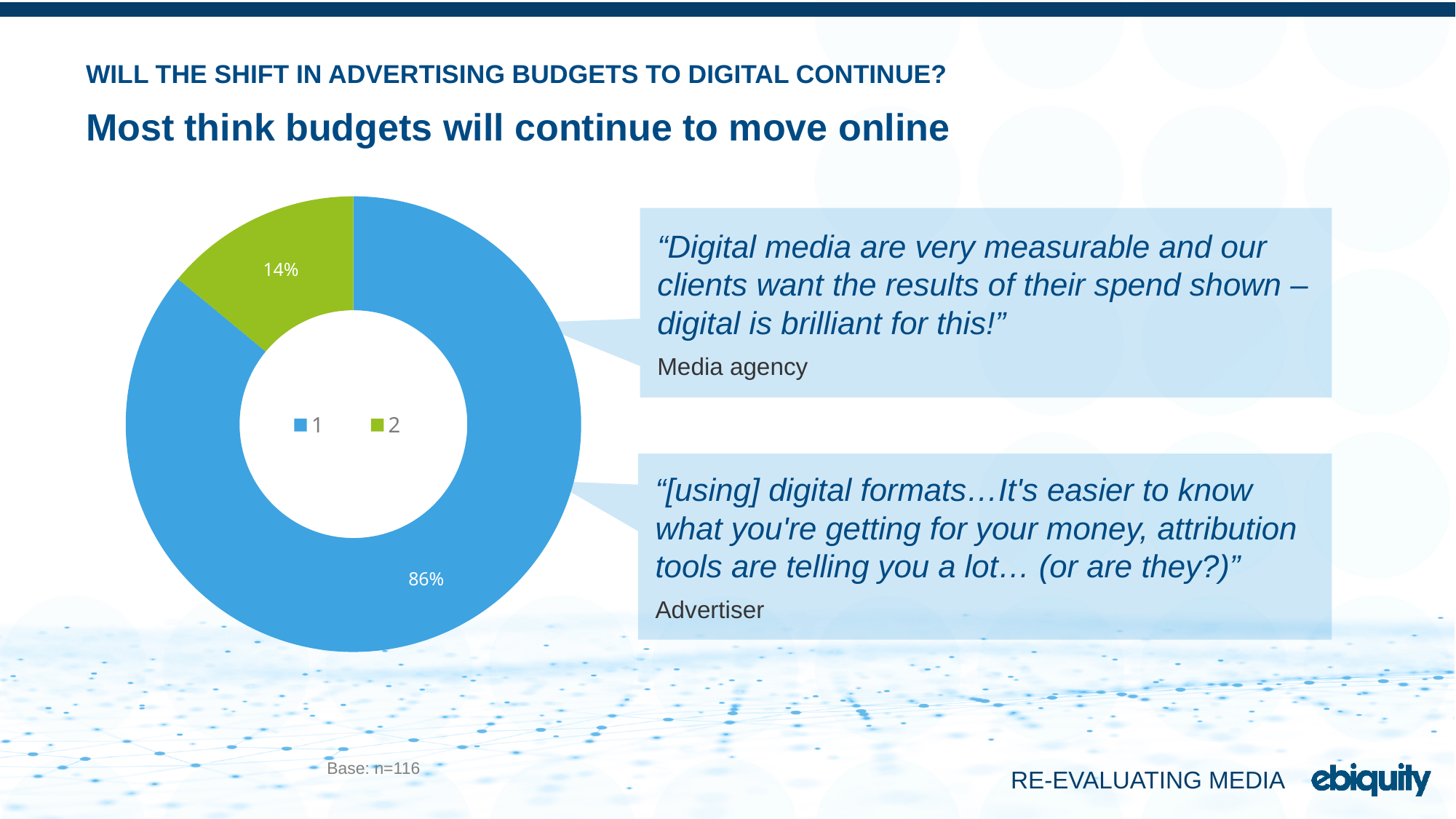
What base sample size is stated below the chart? n=116 What type of chart is shown on the slide? Donut (pie) chart Which slice of the donut chart is the largest? 1 What share of the donut chart does slice 2 represent? 14% What percentage is shown for the blue slice labelled 1? 86% How many slices does the donut chart have? 2 Which slice of the donut chart is the smallest? 2 What colour is the slice labelled 2 in the legend? Green How many entries does the chart legend list? 2 What percentage is shown for the green slice labelled 2? 14% Which is larger, slice 1 or slice 2? 1 What is the difference in percentage points between slice 1 and slice 2? 72